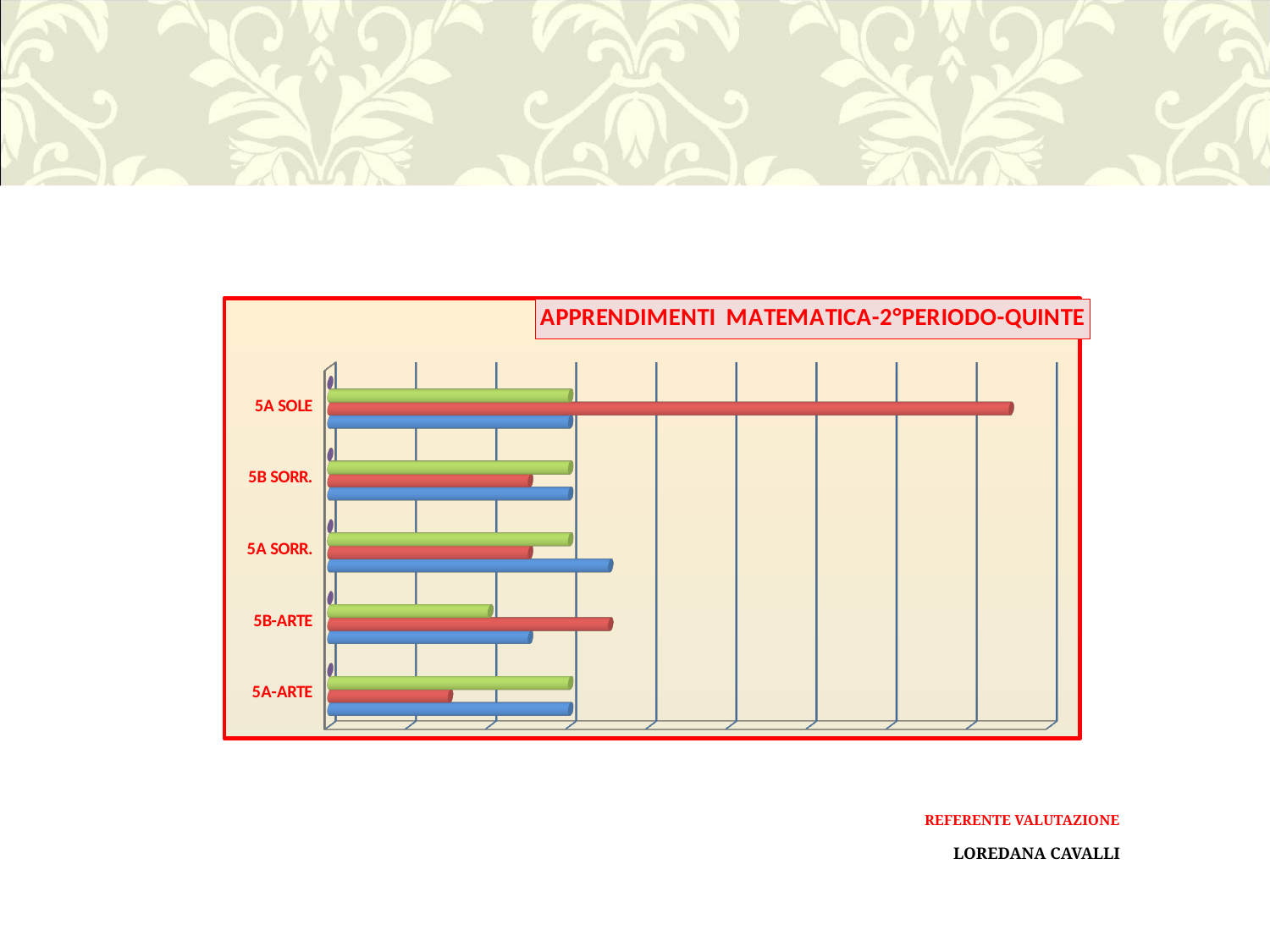
What is the title of the chart? APPRENDIMENTI MATEMATICA-2°PERIODO-QUINTE What kind of chart is shown on the slide? bar chart Is the green bar for 5B-ARTE longer or shorter than the green bar for 5A-ARTE? shorter How many bars are plotted for each class in the chart? 3 What three colours are used for the bars in the chart? green, red and blue Which class has the longest blue bar in the chart? 5A SORR. Which class has the shortest blue bar in the chart? 5B-ARTE Which class has the shortest red bar in the chart? 5A-ARTE Which class has the longest red bar in the chart? 5A SOLE Which class has the shortest green bar in the chart? 5B-ARTE How many categories (classes) are shown on the vertical axis of the chart? 5 Is the red bar for 5A SOLE longer or shorter than the red bar for 5B SORR.? longer